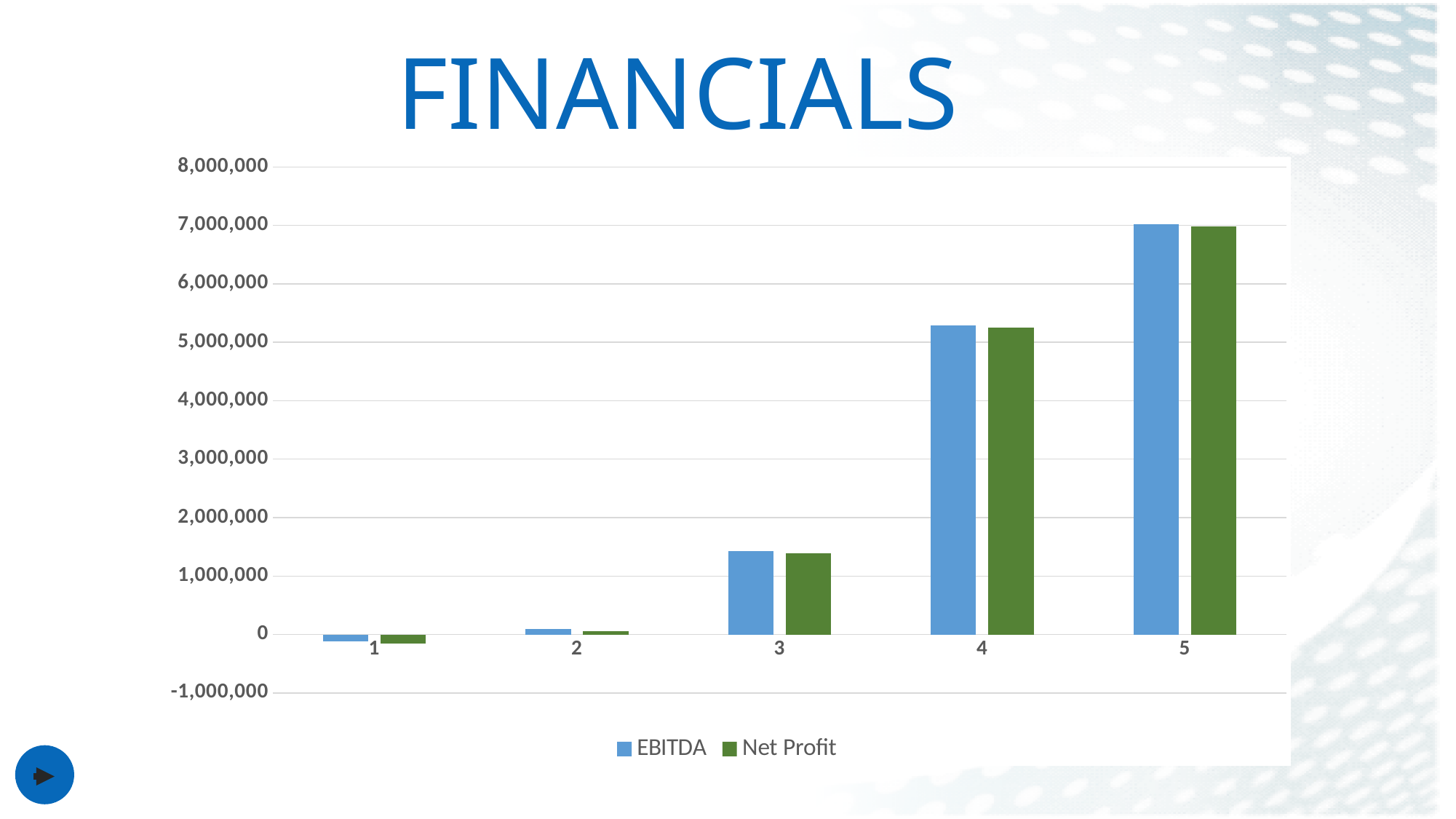
What kind of chart is shown on the slide? bar chart How many categories are shown on the x axis? 5 Which category has the lowest Net Profit value? 1 Is the EBITDA value for category 4 greater or less than 5,000,000? greater Is the Net Profit value for category 1 greater or less than 0? less Which category has the highest EBITDA value? 5 Is the Net Profit value for category 3 greater or less than 2,000,000? less What is the title of the slide? FINANCIALS How many series does the legend list? 2 Which is larger, the EBITDA value for category 4 or the EBITDA value for category 5? category 5 Do the Net Profit values rise or fall from category 1 to category 5? rise